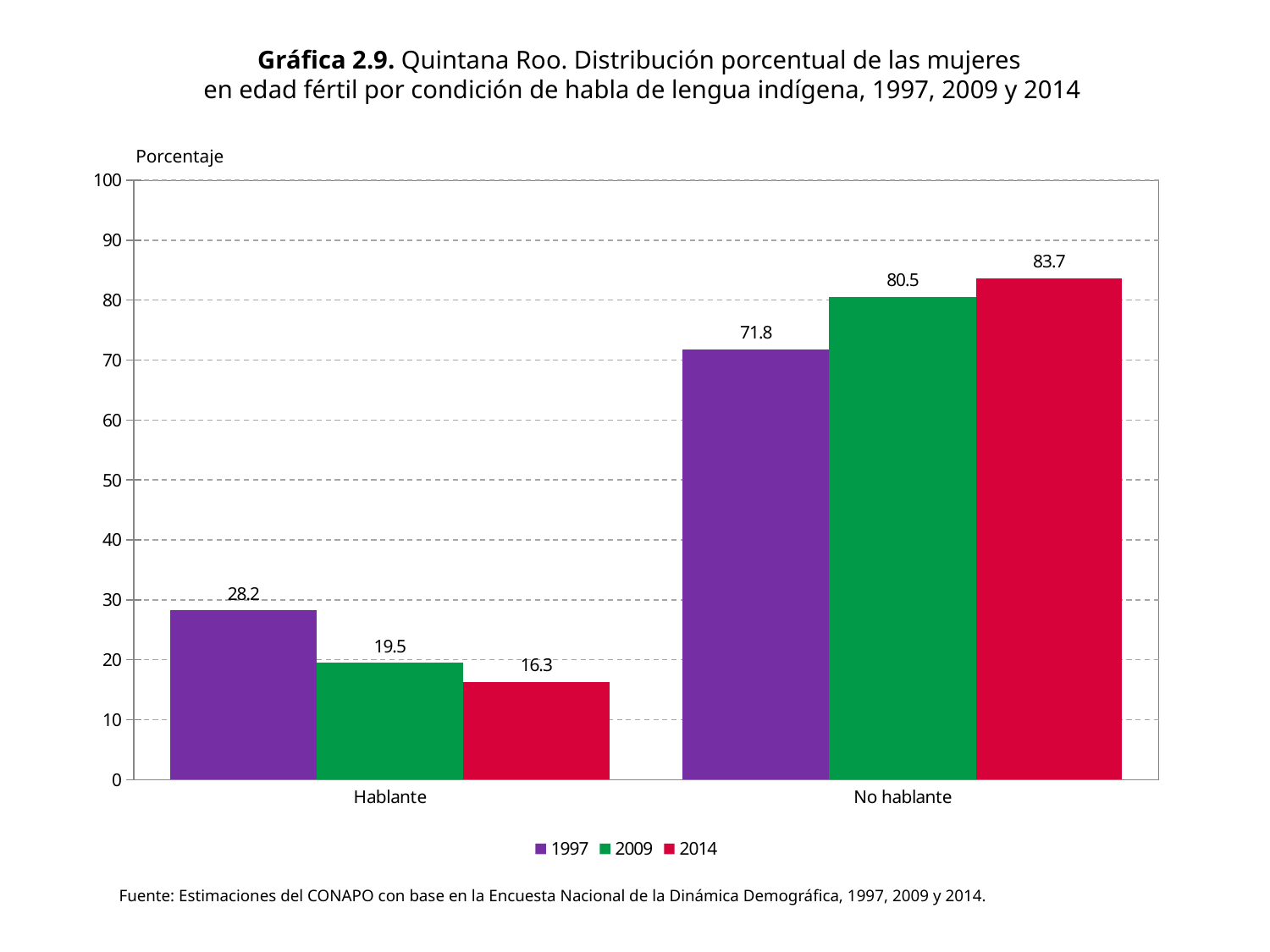
Which year has the highest value for No hablante? 2014 What is the value for Hablante in 2009? 19.5 What is the difference between the No hablante values for 2014 and 1997? 11.9 Which is larger, the Hablante value for 1997 or the Hablante value for 2009? 1997 Is the value for No hablante in 1997 greater or less than 70? greater What is the difference between the Hablante values for 1997 and 2014? 11.9 How many series does the legend list? 3 What kind of chart is shown? Bar chart Which year has the lowest value for Hablante? 2014 What is the value for Hablante in 1997? 28.2 What is the label on the vertical axis? Porcentaje What is the value for No hablante in 2014? 83.7